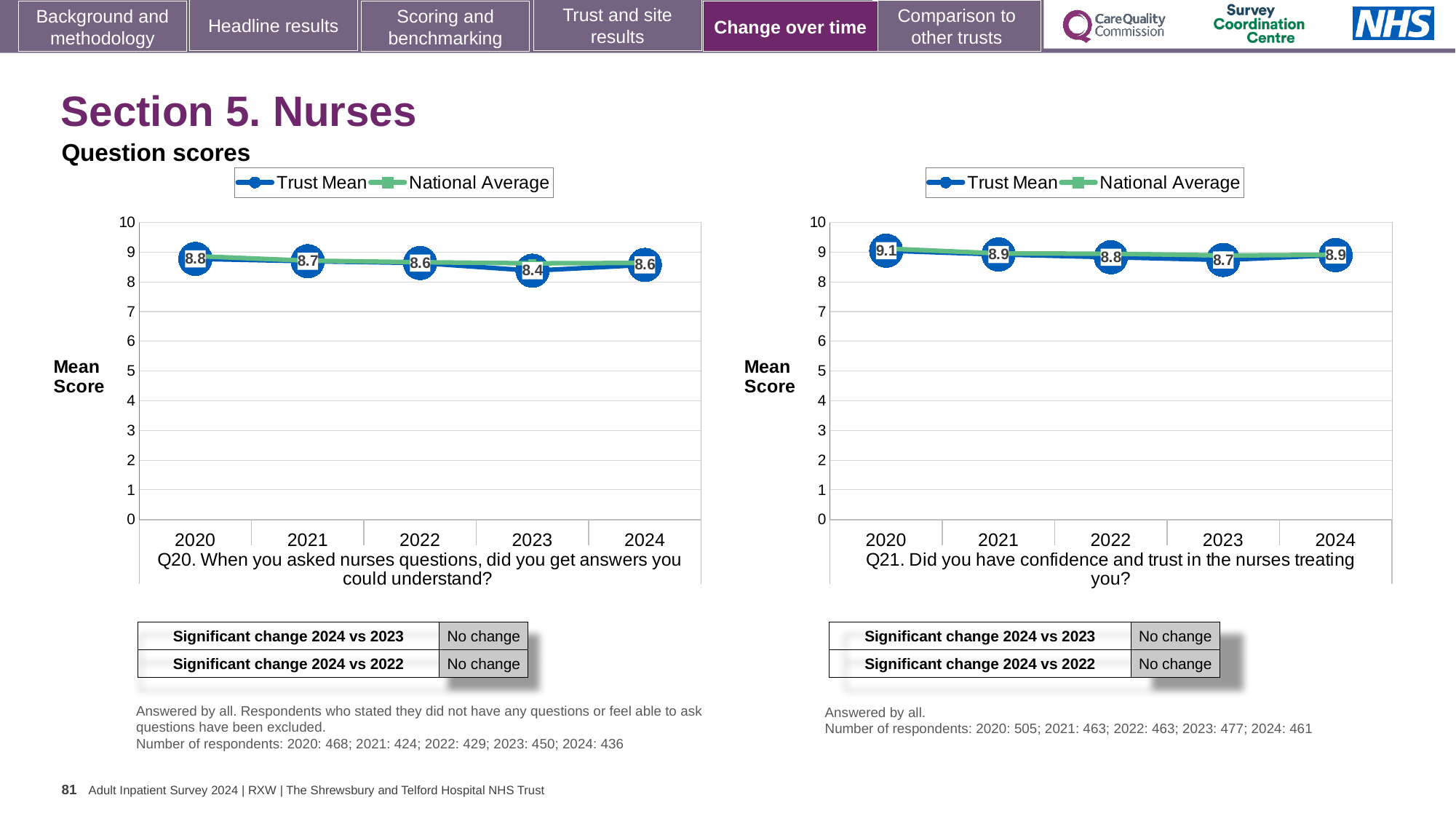
On the Q20 chart (left), which year has the lowest Trust Mean score? 2023 On the Q20 chart (left), what is the Trust Mean score for 2023? 8.4 On the Q21 chart (right), which is larger, the Trust Mean score for 2021 or for 2023? 2021 On the Q20 chart (left), what is the Trust Mean score for 2020? 8.8 What type of chart is the Q20 chart (left)? Line chart On the Q21 chart (right), is the Trust Mean score for 2020 greater or less than 9? greater On the Q21 chart (right), what is the Trust Mean score for 2020? 9.1 How many years are shown on the x axis of the Q20 chart (left)? 5 On the Q21 chart (right), which year has the highest Trust Mean score? 2020 On the Q20 chart (left), what is the difference between the Trust Mean scores for 2020 and 2023? 0.4 How many series does the legend of the Q21 chart (right) list? 2 On the Q21 chart (right), what is the Trust Mean score for 2024? 8.9